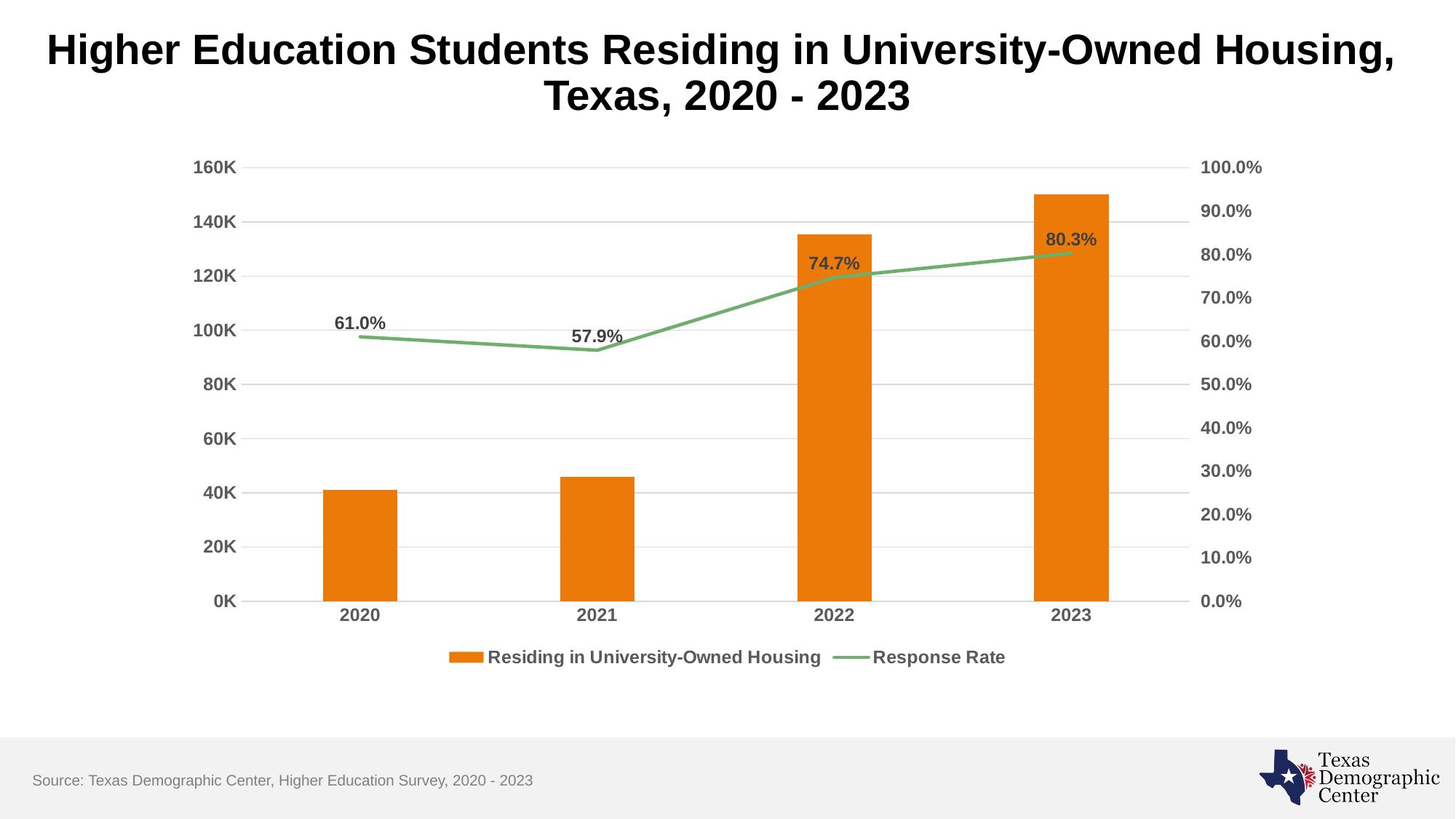
Which year has the lowest Response Rate? 2021 What is the Response Rate for 2021? 57.9% How many years are shown on the x axis? 4 Which year has the highest Response Rate? 2023 Is the value for Residing in University-Owned Housing in 2020 greater or less than 60K? less What is the Response Rate for 2020? 61.0% What is the difference between the Response Rate in 2023 and in 2022? 5.6% What is the Response Rate for 2023? 80.3% Is the Residing in University-Owned Housing value larger in 2021 or in 2022? 2022 How many series does the legend list? 2 Is the value for Residing in University-Owned Housing in 2022 greater or less than 120K? greater Which year has the tallest bar for Residing in University-Owned Housing? 2023